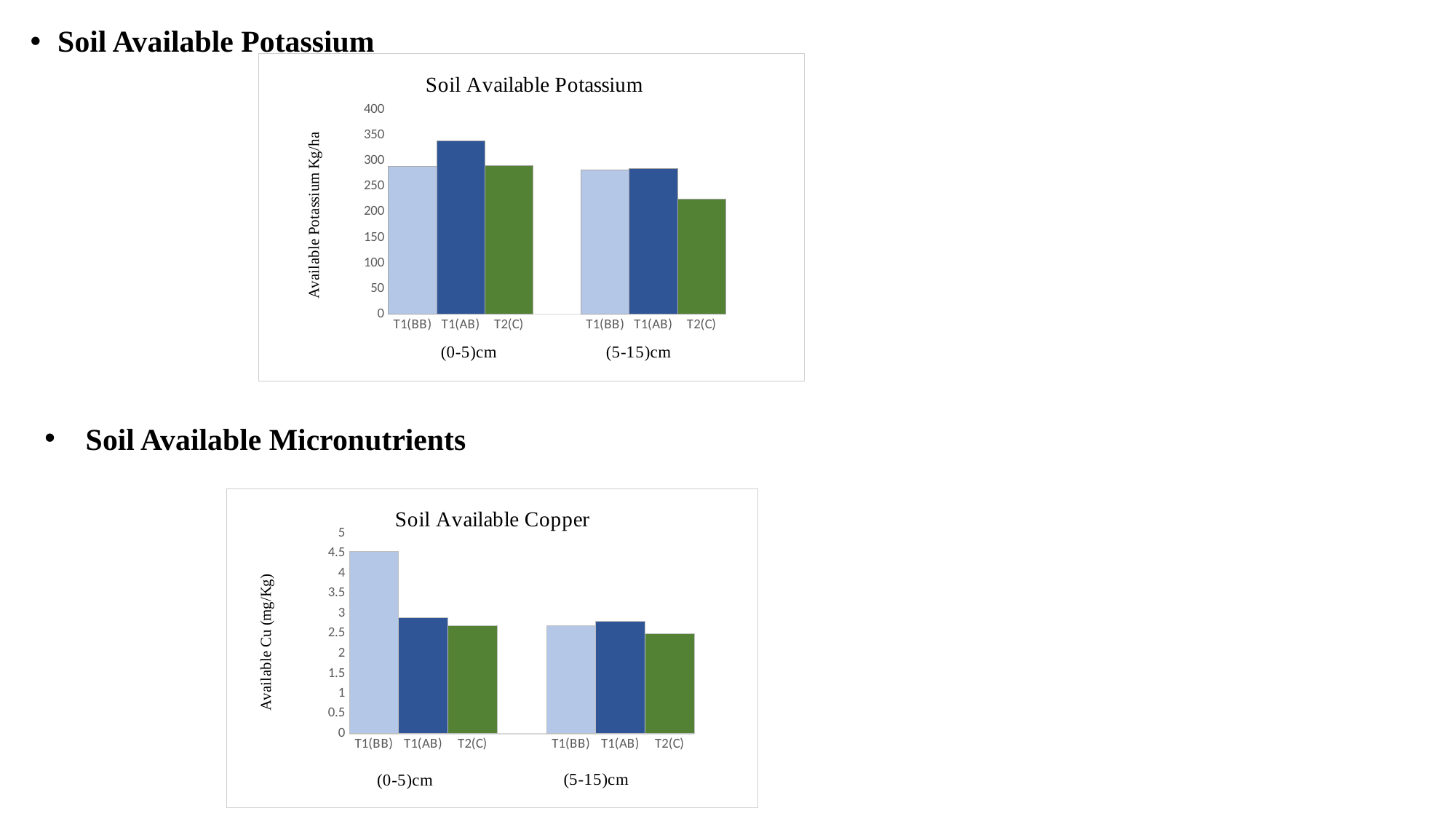
What is the y-axis title of the Soil Available Potassium chart? Available Potassium Kg/ha In the Soil Available Copper chart, is the value for T1(BB) at (0-5)cm greater or less than 4? greater In the Soil Available Potassium chart, which is larger: T1(AB) at (0-5)cm or T1(AB) at (5-15)cm? T1(AB) at (0-5)cm In the Soil Available Potassium chart, is the value for T1(AB) at (0-5)cm greater or less than 300? greater In the Soil Available Copper chart, which bar is the highest? T1(BB) at (0-5)cm What kind of chart is the Soil Available Copper chart? bar chart In the Soil Available Potassium chart, is the value for T2(C) at (5-15)cm greater or less than 250? less How many bars are plotted in the Soil Available Potassium chart? 6 In the Soil Available Potassium chart, which bar is the lowest? T2(C) at (5-15)cm In the Soil Available Copper chart, which bar is the lowest? T2(C) at (5-15)cm In the Soil Available Potassium chart, which bar is the highest? T1(AB) at (0-5)cm In the Soil Available Copper chart, which is larger: T1(BB) at (0-5)cm or T1(AB) at (0-5)cm? T1(BB) at (0-5)cm